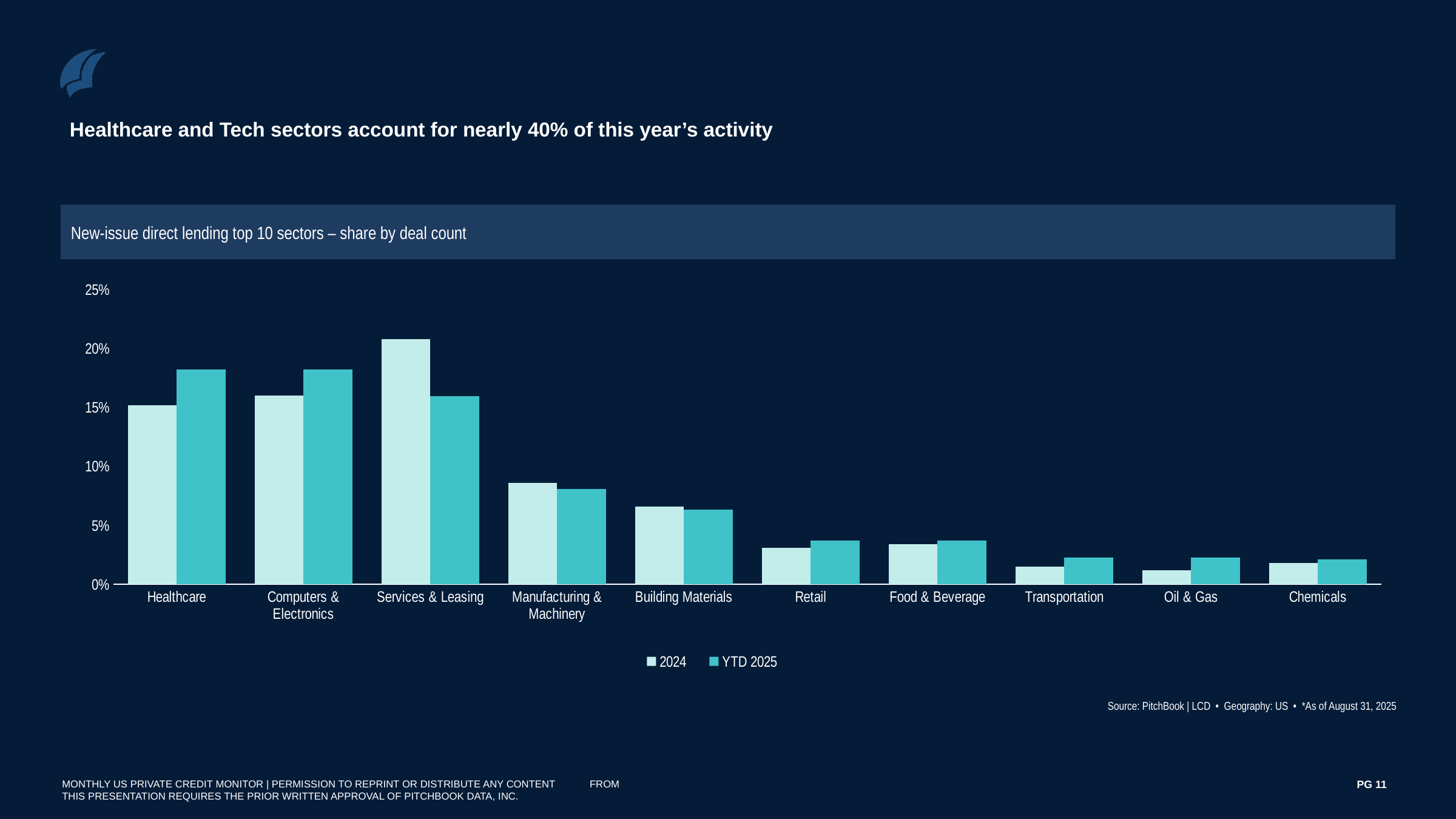
For Services & Leasing, which is larger: the 2024 value or the YTD 2025 value? 2024 Is the 2024 value for Manufacturing & Machinery greater or less than 10%? less Which sector has the highest 2024 share by deal count? Services & Leasing For Healthcare, which is larger: the 2024 value or the YTD 2025 value? YTD 2025 Is the 2024 value for Services & Leasing greater or less than 20%? greater What kind of chart is shown on the slide? Bar chart Is the YTD 2025 value for Building Materials greater or less than 5%? greater How many sectors are shown on the x axis of the chart? 10 What is the title of the chart? New-issue direct lending top 10 sectors – share by deal count How many series does the chart's legend list? 2 For Oil & Gas, which is larger: the 2024 value or the YTD 2025 value? YTD 2025